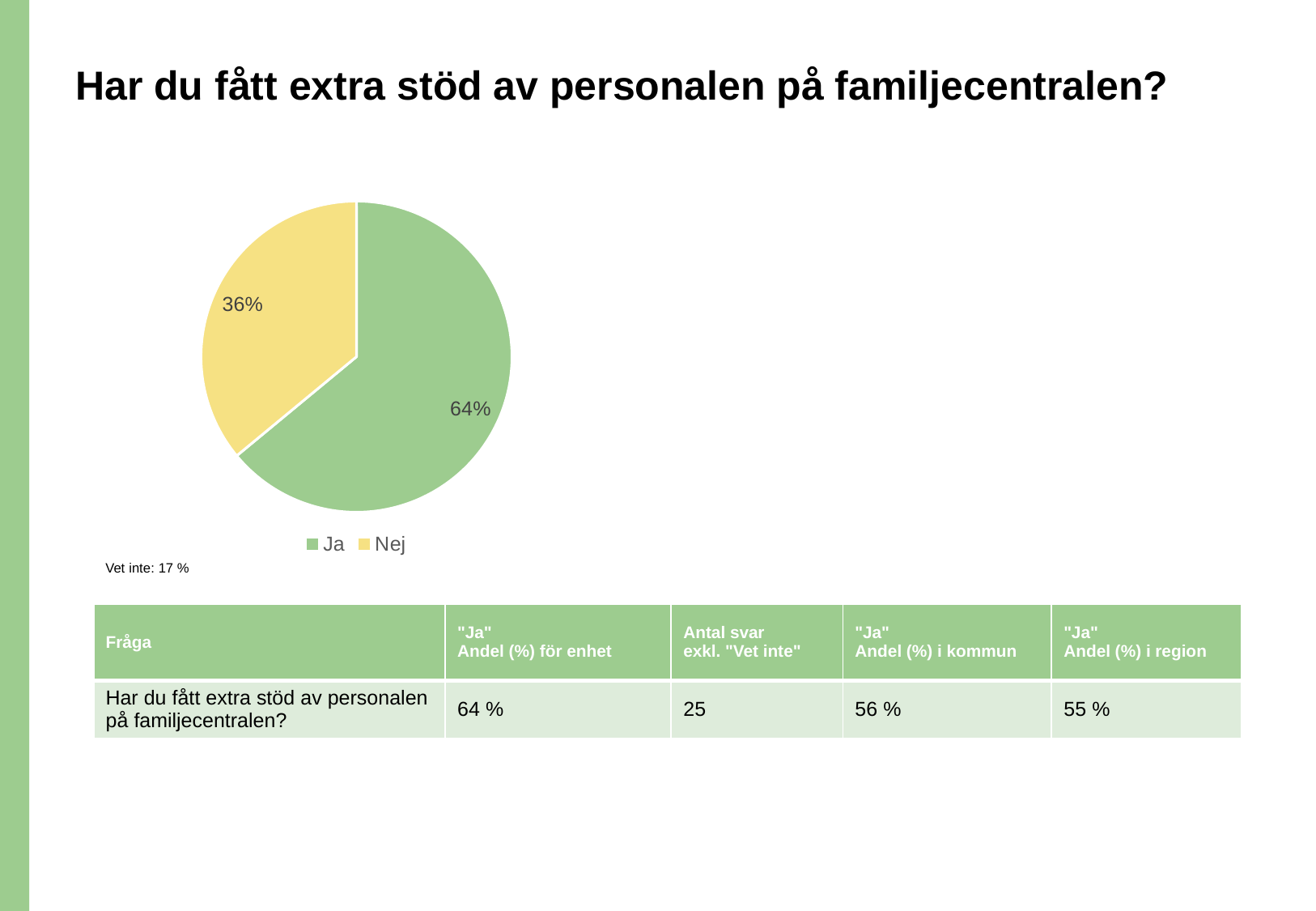
Which slice of the pie is the smallest? Nej What is the difference in percentage points between the "Ja" and "Nej" slices? 28 What share of the pie does the "Ja" slice represent? 64% What colour is the "Ja" slice in the pie chart? green What share of the pie does the "Nej" slice represent? 36% What colour is the "Nej" slice in the pie chart? yellow How many entries does the legend list? 2 Which is larger, the "Ja" slice or the "Nej" slice? Ja What type of chart is shown on the slide? pie chart Which slice of the pie is the largest? Ja How many slices does the pie chart have? 2 Is the share of the "Nej" slice greater or less than 50%? less